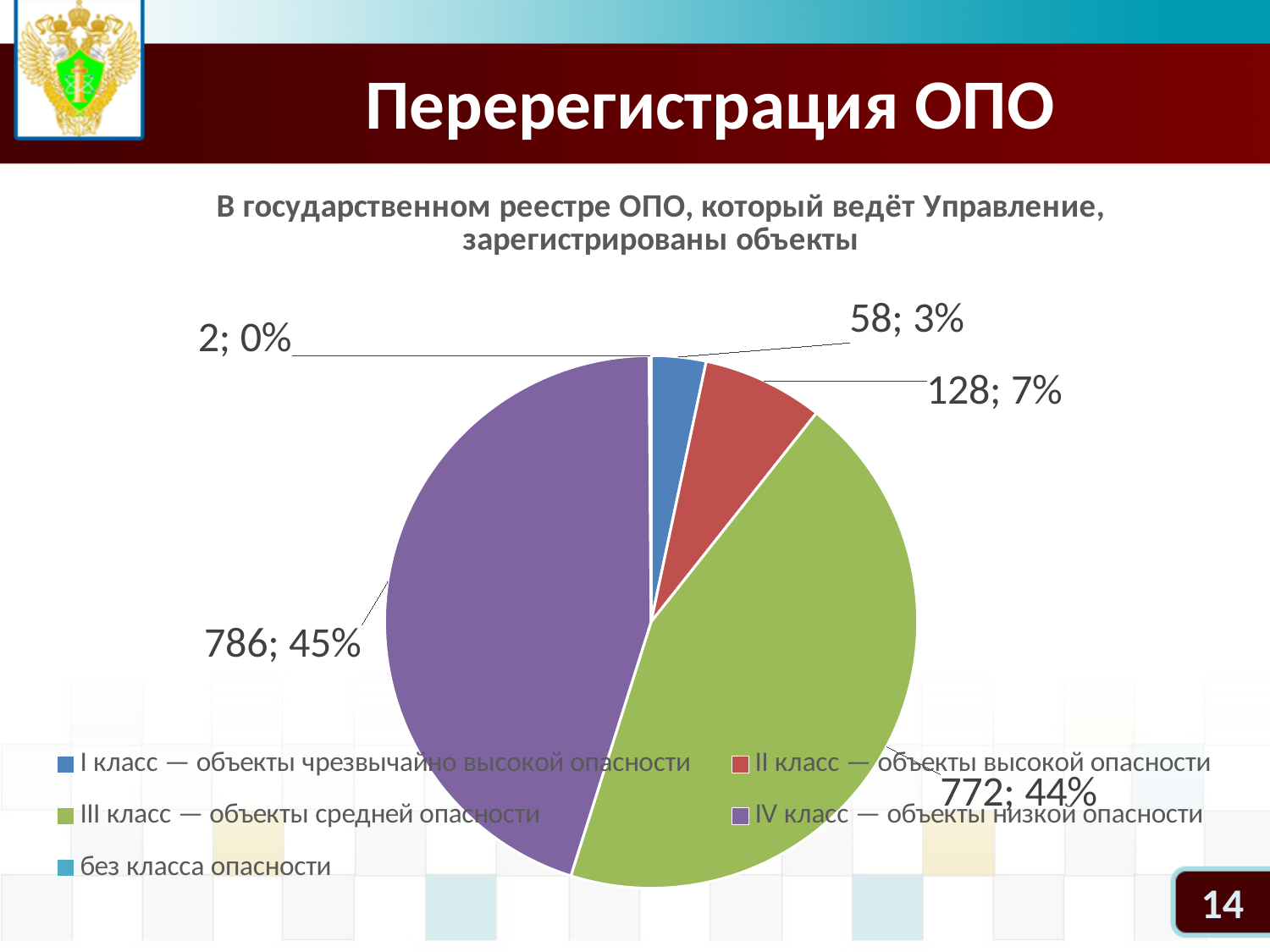
Which category has the largest value in the pie chart? IV класс — объекты низкой опасности What is the value shown for 'I класс — объекты чрезвычайно высокой опасности'? 58 What share of the pie does 'III класс — объекты средней опасности' take? 44% What is the difference between the values for 'II класс — объекты высокой опасности' and 'I класс — объекты чрезвычайно высокой опасности'? 70 What is the value shown for 'III класс — объекты средней опасности'? 772 Which category has the smallest value in the pie chart? без класса опасности What kind of chart is shown on the slide? pie chart What is the value shown for 'II класс — объекты высокой опасности'? 128 What share of the pie does 'II класс — объекты высокой опасности' take? 7% What is the value shown for 'без класса опасности'? 2 What is the value shown for 'IV класс — объекты низкой опасности'? 786 How many categories does the legend of the pie chart list? 5